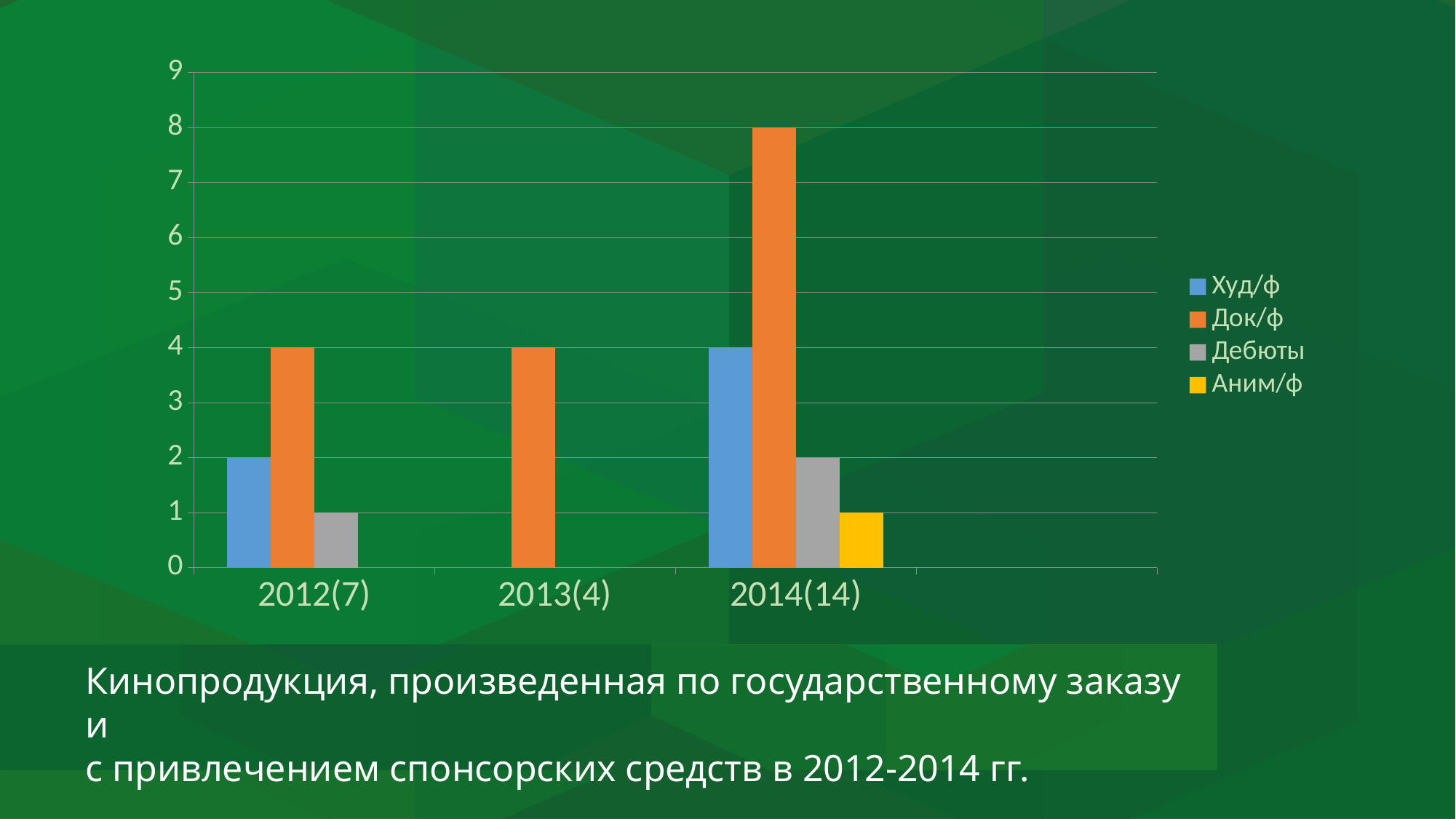
What is the value of Аним/ф for 2014(14)? 1 In which year category does Док/ф reach its highest value? 2014(14) What kind of chart is shown on the slide? bar chart Which colour represents the Аним/ф series in the legend? yellow How many series does the legend list? 4 How many year categories are shown on the x axis? 3 What is the difference between Док/ф and Худ/ф in 2014(14)? 4 What is the value of Худ/ф for 2012(7)? 2 Does the value of Док/ф rise or fall from 2013(4) to 2014(14)? rise Which is larger in 2012(7): Док/ф or Худ/ф? Док/ф What is the value of Дебюты for 2014(14)? 2 What is the value of Док/ф for 2014(14)? 8